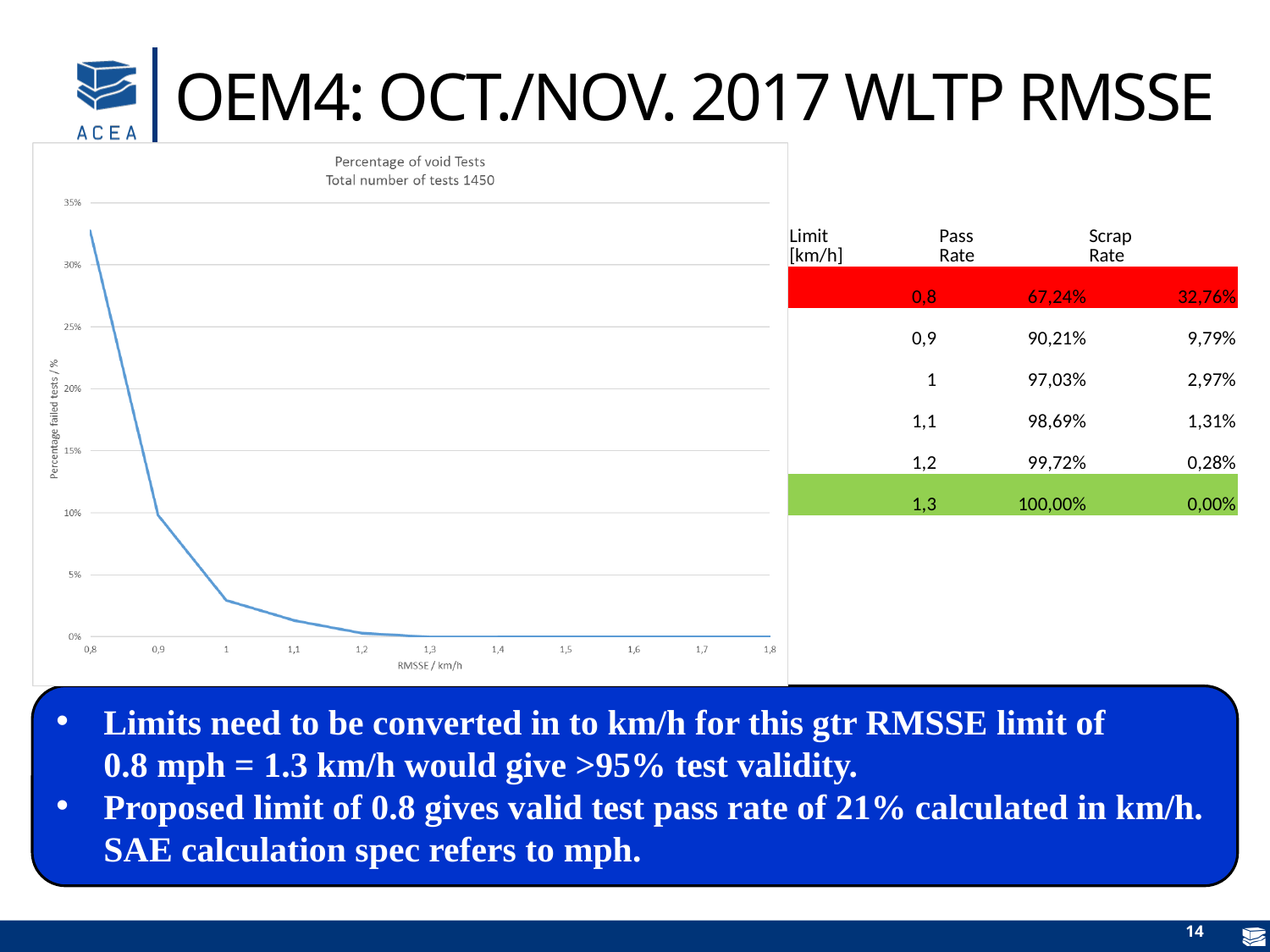
How many tick values are labelled on the x axis of the chart? 11 Is the percentage of failed tests at RMSSE 0,9 km/h greater or less than 15%? less What is the title of the chart? Percentage of void Tests Which has a higher percentage of failed tests: RMSSE 0,9 km/h or RMSSE 1 km/h? 0,9 Is the percentage of failed tests at RMSSE 0,8 km/h greater or less than 30%? greater What kind of chart is shown on the slide? line chart According to the chart subtitle, what is the total number of tests? 1450 Does the percentage of failed tests rise or fall as RMSSE increases along the x axis? fall Is the percentage of failed tests at RMSSE 1 km/h greater or less than 5%? less At which RMSSE value on the x axis is the percentage of failed tests highest? 0,8